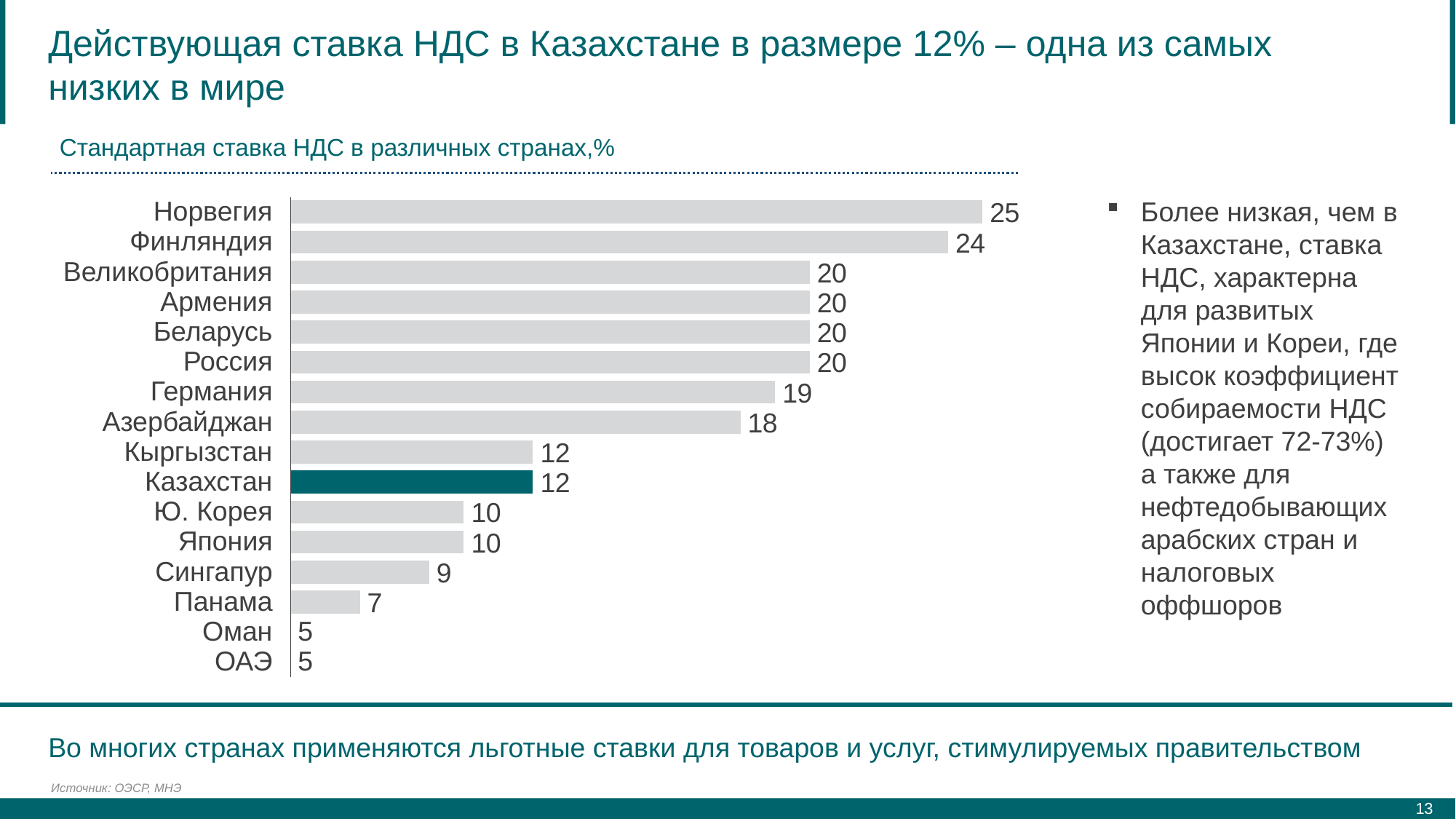
What type of chart is shown on the slide? Bar chart What is the value shown for Сингапур? 9 What is the value shown for Азербайджан? 18 Which country's bar is highlighted in a different (teal) colour? Казахстан What is the difference between the values for Германия and Япония? 9 What is the difference between the values for Норвегия and Казахстан? 13 What value is shown for Казахстан in the chart? 12 Which has a higher value, Панама or Ю. Корея? Ю. Корея Which has a higher value, Финляндия or Россия? Финляндия How many countries are shown in the chart? 16 Which country has the highest VAT rate in the chart? Норвегия What is the standard VAT rate shown for Норвегия? 25